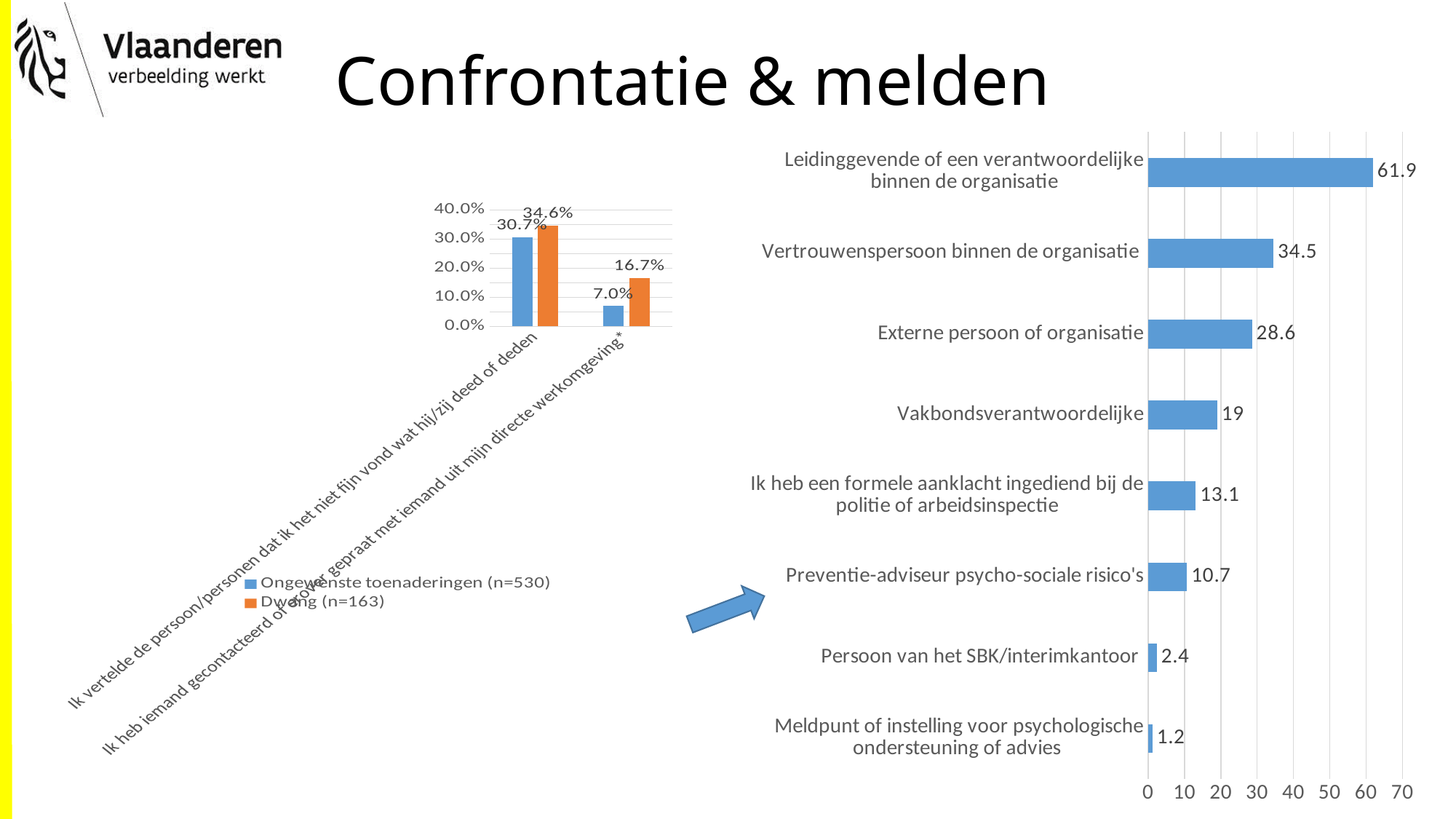
In the grouped bar chart on the left, how many series does the legend list? 2 In the grouped bar chart on the left, which series has the larger value for 'Ik heb iemand gecontacteerd of erover gepraat met iemand uit mijn directe werkomgeving*'? Dwang (n=163) In the horizontal bar chart on the right, what is the value for 'Persoon van het SBK/interimkantoor'? 2.4 In the horizontal bar chart on the right, which category has the lowest value? Meldpunt of instelling voor psychologische ondersteuning of advies In the grouped bar chart on the left, what is the value of the 'Dwang (n=163)' series for 'Ik vertelde de persoon/personen dat ik het niet fijn vond wat hij/zij deed of deden'? 34.6% In the horizontal bar chart on the right, what is the value for 'Vertrouwenspersoon binnen de organisatie'? 34.5 In the horizontal bar chart on the right, which category has the highest value? Leidinggevende of een verantwoordelijke binnen de organisatie In the grouped bar chart on the left, what is the value of the 'Ongewenste toenaderingen (n=530)' series for 'Ik heb iemand gecontacteerd of erover gepraat met iemand uit mijn directe werkomgeving*'? 7.0% In the horizontal bar chart on the right, is the value for 'Ik heb een formele aanklacht ingediend bij de politie of arbeidsinspectie' greater or less than 10? greater In the horizontal bar chart on the right, what is the difference between the values for 'Externe persoon of organisatie' and 'Vakbondsverantwoordelijke'? 9.6 In the horizontal bar chart on the right, how many categories are shown? 8 What kind of chart is shown on the right side of the slide? Bar chart